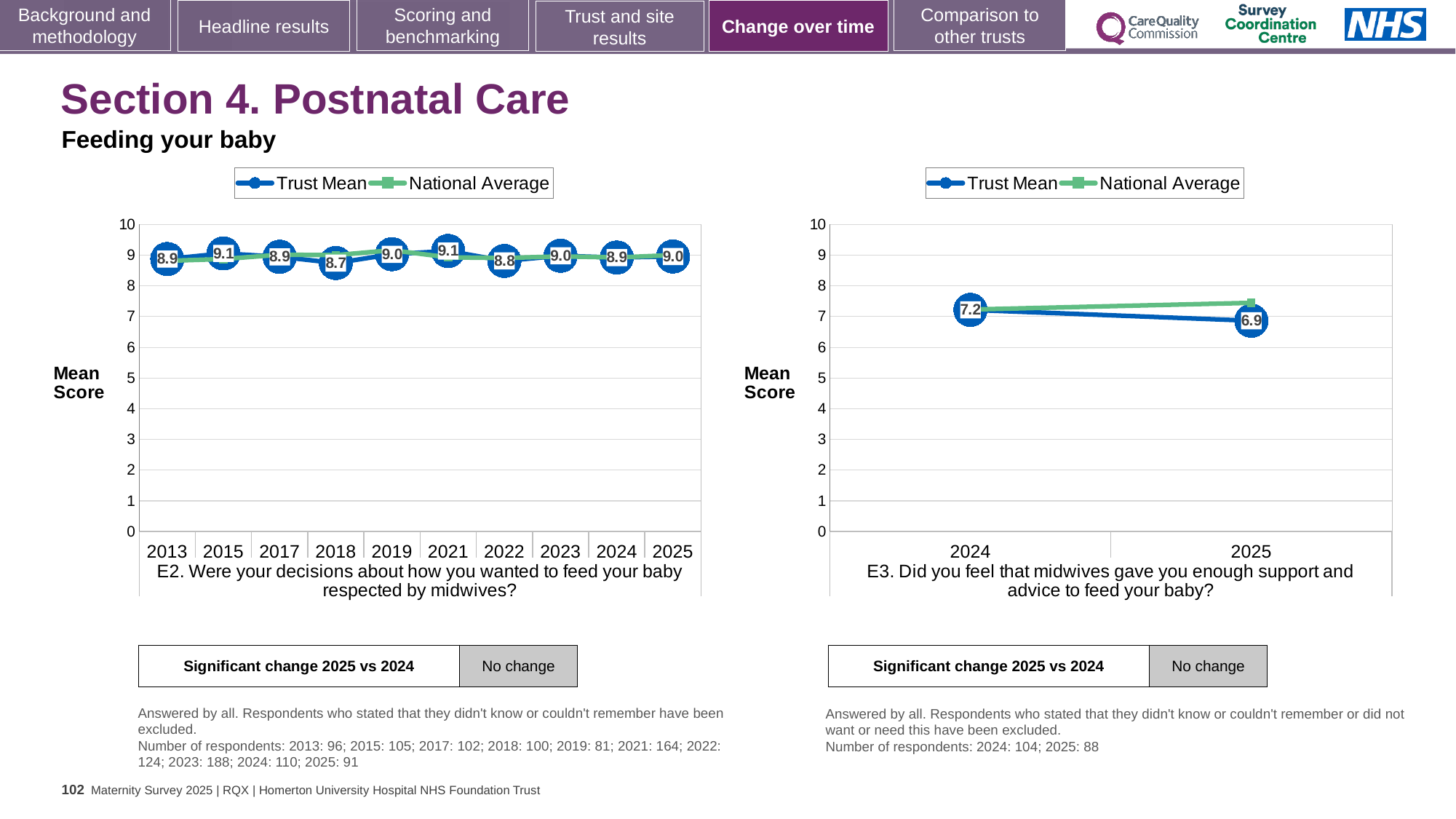
In the right chart (E3), which year has the higher Trust Mean, 2024 or 2025? 2024 In the left chart (E2), what is the Trust Mean for 2025? 9.0 In the left chart (E2), which year has the lowest Trust Mean? 2018 In the left chart (E2), what is the Trust Mean for 2018? 8.7 In the right chart (E3), is the National Average for 2025 greater or less than 7? greater In the right chart (E3), does the Trust Mean rise or fall from 2024 to 2025? Fall In the right chart (E3), what is the Trust Mean for 2024? 7.2 How many years are plotted on the x axis of the left chart (E2)? 10 In the right chart (E3), what is the Trust Mean for 2025? 6.9 What kind of chart is the left chart (E2)? Line chart How many series does the legend of the right chart (E3) list? 2 In the right chart (E3), what is the difference between the Trust Mean for 2024 and 2025? 0.3